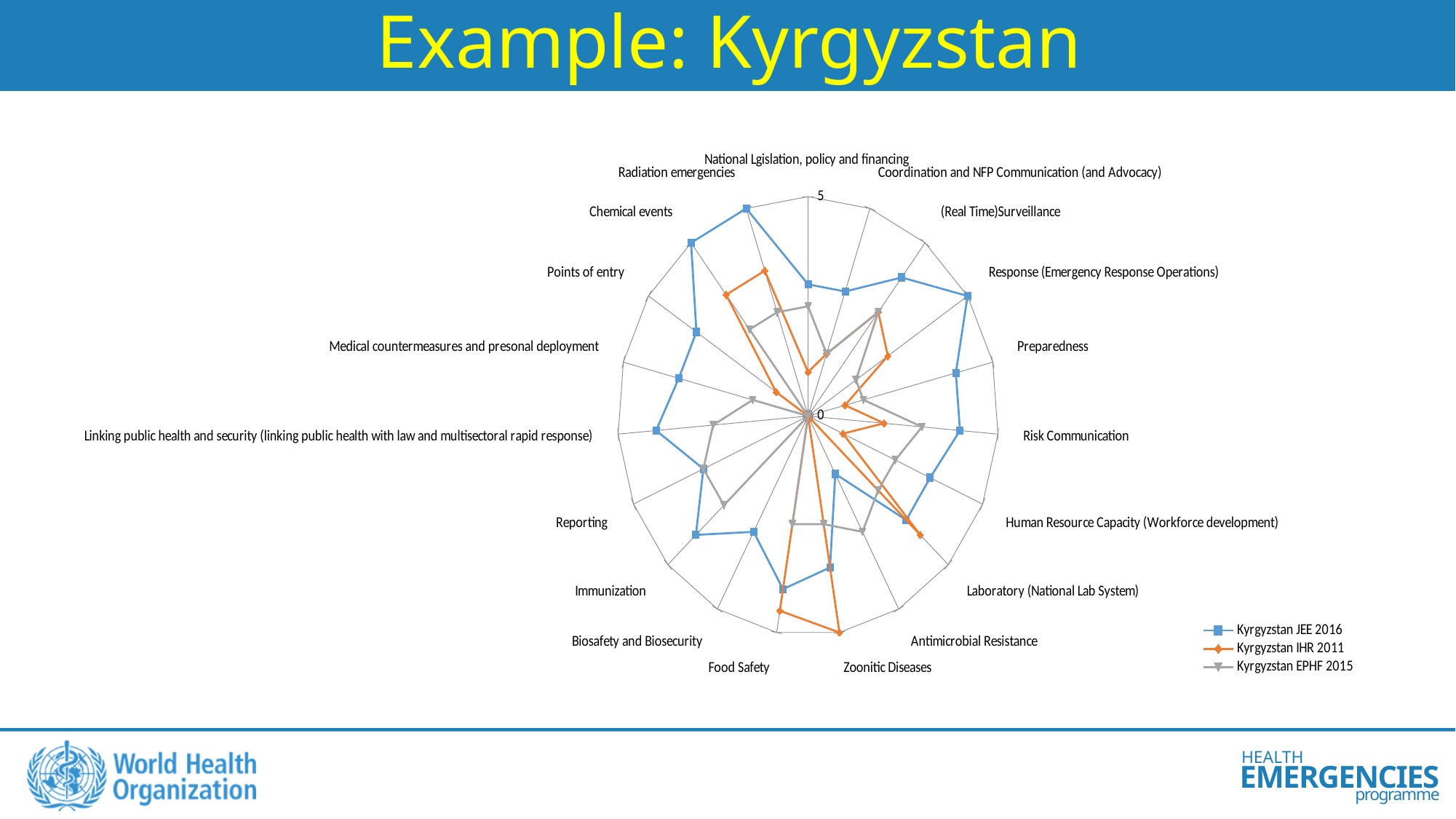
How many series does the legend list? 3 For Points of entry, which series has the higher value: Kyrgyzstan JEE 2016 or Kyrgyzstan IHR 2011? Kyrgyzstan JEE 2016 Which series is drawn in orange with diamond markers? Kyrgyzstan IHR 2011 For Chemical events, which series has the lower value: Kyrgyzstan JEE 2016 or Kyrgyzstan IHR 2011? Kyrgyzstan IHR 2011 For Human Resource Capacity (Workforce development), which series has the lowest value? Kyrgyzstan IHR 2011 For Zoonotic Diseases, which series has the higher value: Kyrgyzstan IHR 2011 or Kyrgyzstan JEE 2016? Kyrgyzstan IHR 2011 What kind of chart is shown on the slide? Radar chart What is the maximum value shown on the radar chart's axis? 5 In which category does the Kyrgyzstan IHR 2011 series reach its highest value? Zoonitic Diseases What is the value of Kyrgyzstan IHR 2011 for Zoonotic Diseases? 5 How many categories (axes) does the radar chart have? 19